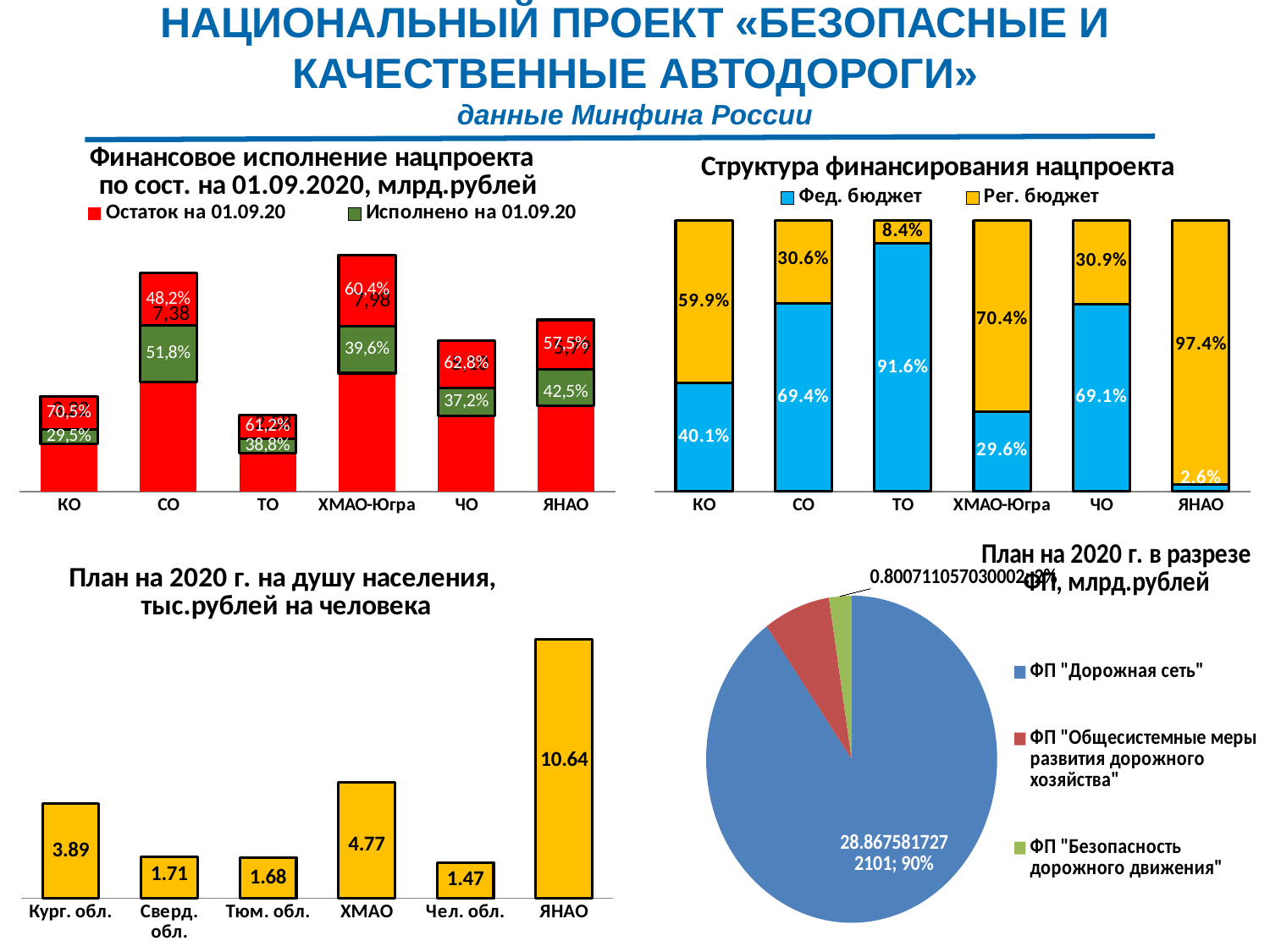
What type of chart is 'План на 2020 г. в разрезе ФП, млрд.рублей'? Pie chart In the pie chart 'План на 2020 г. в разрезе ФП, млрд.рублей', what share does ФП "Дорожная сеть" have? 90% In the chart 'Структура финансирования нацпроекта', which is larger for ХМАО-Югра: the Фед. бюджет share or the Рег. бюджет share? Рег. бюджет In the chart 'Структура финансирования нацпроекта', what is the share of Фед. бюджет for ТО? 91.6% In the chart 'План на 2020 г. на душу населения, тыс.рублей на человека', what is the value for ЯНАО? 10.64 In the chart 'План на 2020 г. на душу населения, тыс.рублей на человека', which region has the lowest value? Чел. обл. In the chart 'План на 2020 г. на душу населения, тыс.рублей на человека', how many regions are shown? 6 In the chart 'Финансовое исполнение нацпроекта по сост. на 01.09.2020', what is the 'Исполнено на 01.09.20' share for СО? 51,8% In the chart 'Структура финансирования нацпроекта', which region has the highest share of Рег. бюджет? ЯНАО In the chart 'Финансовое исполнение нацпроекта по сост. на 01.09.2020', what is the 'Остаток на 01.09.20' share for КО? 70,5% In the chart 'План на 2020 г. на душу населения, тыс.рублей на человека', what is the difference between the values for ХМАО and Кург. обл.? 0.88 In the chart 'Структура финансирования нацпроекта', how many series does the legend list? 2